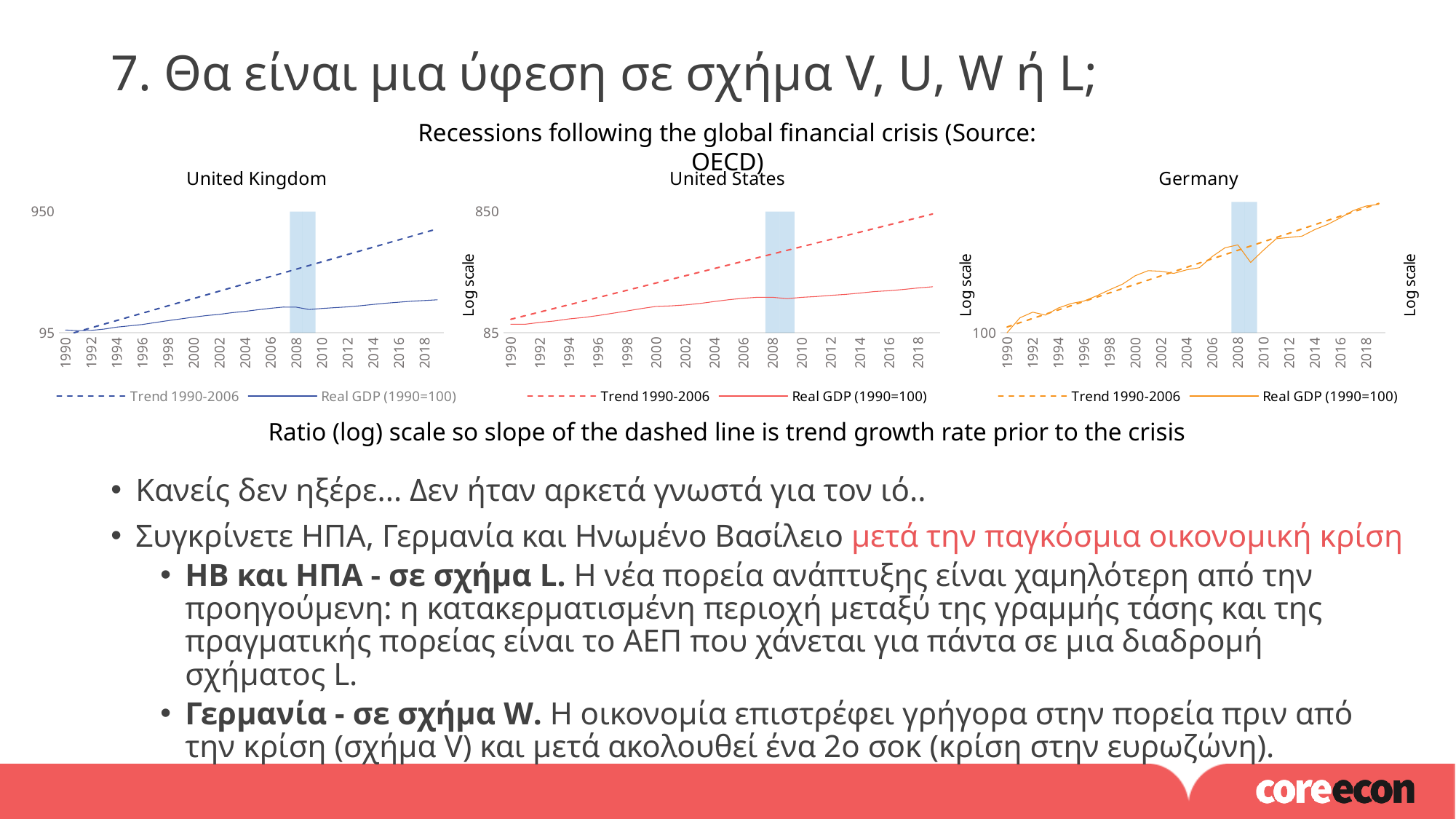
What kind of chart is the United Kingdom chart? Line chart What is the overall title shown above the three charts? Recessions following the global financial crisis (Source: OECD) In the United Kingdom chart, which series is higher in 2018: Trend 1990-2006 or Real GDP (1990=100)? Trend 1990-2006 How many series does the legend of the United States chart list? 2 In the United Kingdom chart, is the Real GDP (1990=100) value in 2018 greater or less than 950? less In the United Kingdom chart, does the Real GDP (1990=100) line rise or fall from 1990 to 2018? Rise What is the first year shown on the x axis of the Germany chart? 1990 What are the two series named in the legend of the Germany chart? Trend 1990-2006 and Real GDP (1990=100) In the United States chart, does the Trend 1990-2006 line rise or fall along the x axis? Rise In the United States chart, which series is higher in 2018: Trend 1990-2006 or Real GDP (1990=100)? Trend 1990-2006 In the Germany chart, is the Real GDP (1990=100) value in 2018 greater or less than 100? greater In the United States chart, is the Real GDP (1990=100) value in 2018 greater or less than 850? less